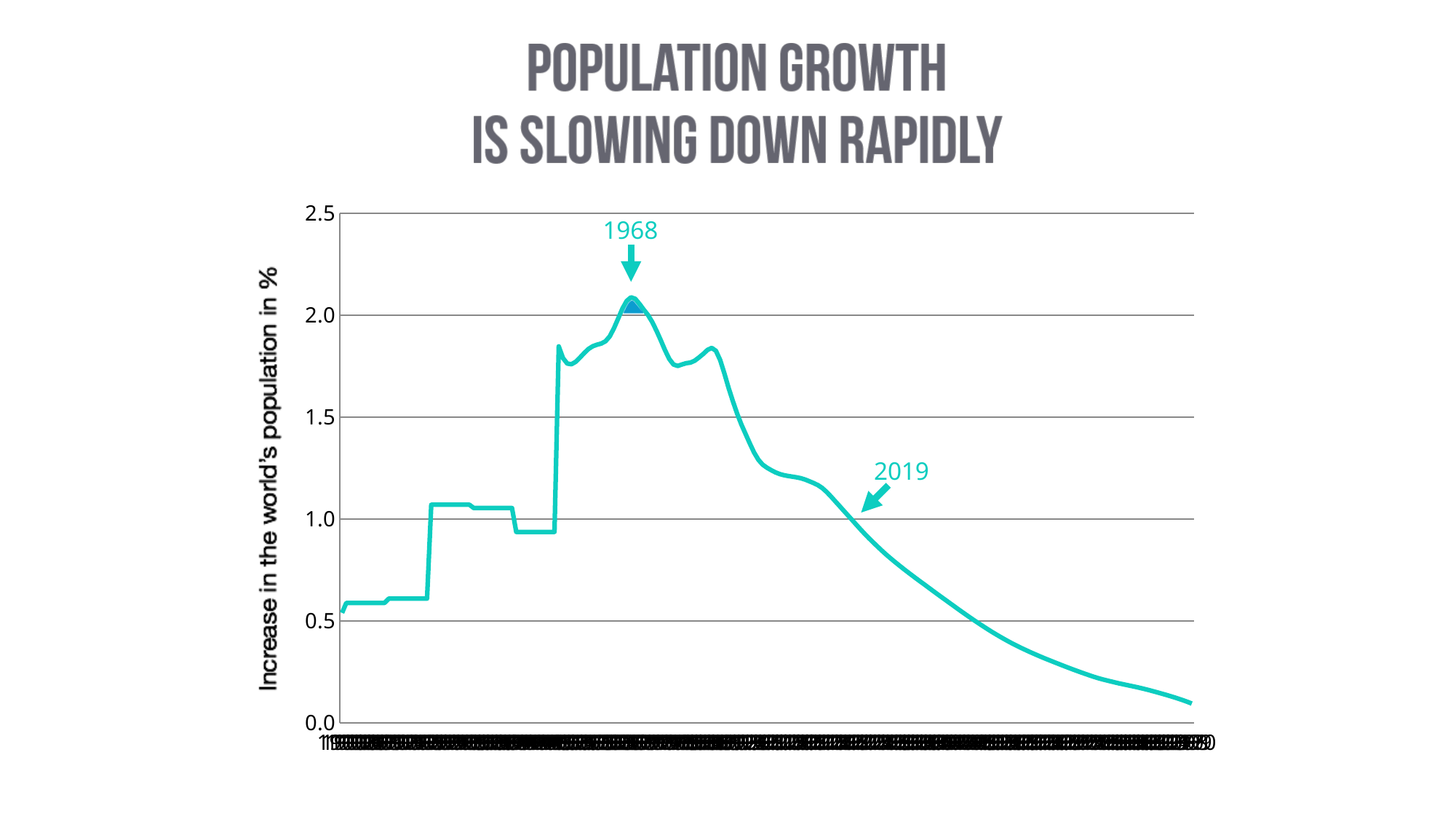
Is the value at 2019 greater or less than 1.5? less What kind of chart is shown on the slide? line chart Which annotated year marks the peak of the line? 1968 What is the title of the slide? Population growth is slowing down rapidly Which annotated year has the higher value, 1968 or 2019? 1968 What is the highest tick value shown on the vertical axis? 2.5 Is the value at 2019 greater or less than 0.5? greater What is the label on the vertical axis? Increase in the world's population in % Does the line rise or fall after 1968? fall Is the value at the right end of the line greater or less than 0.5? less